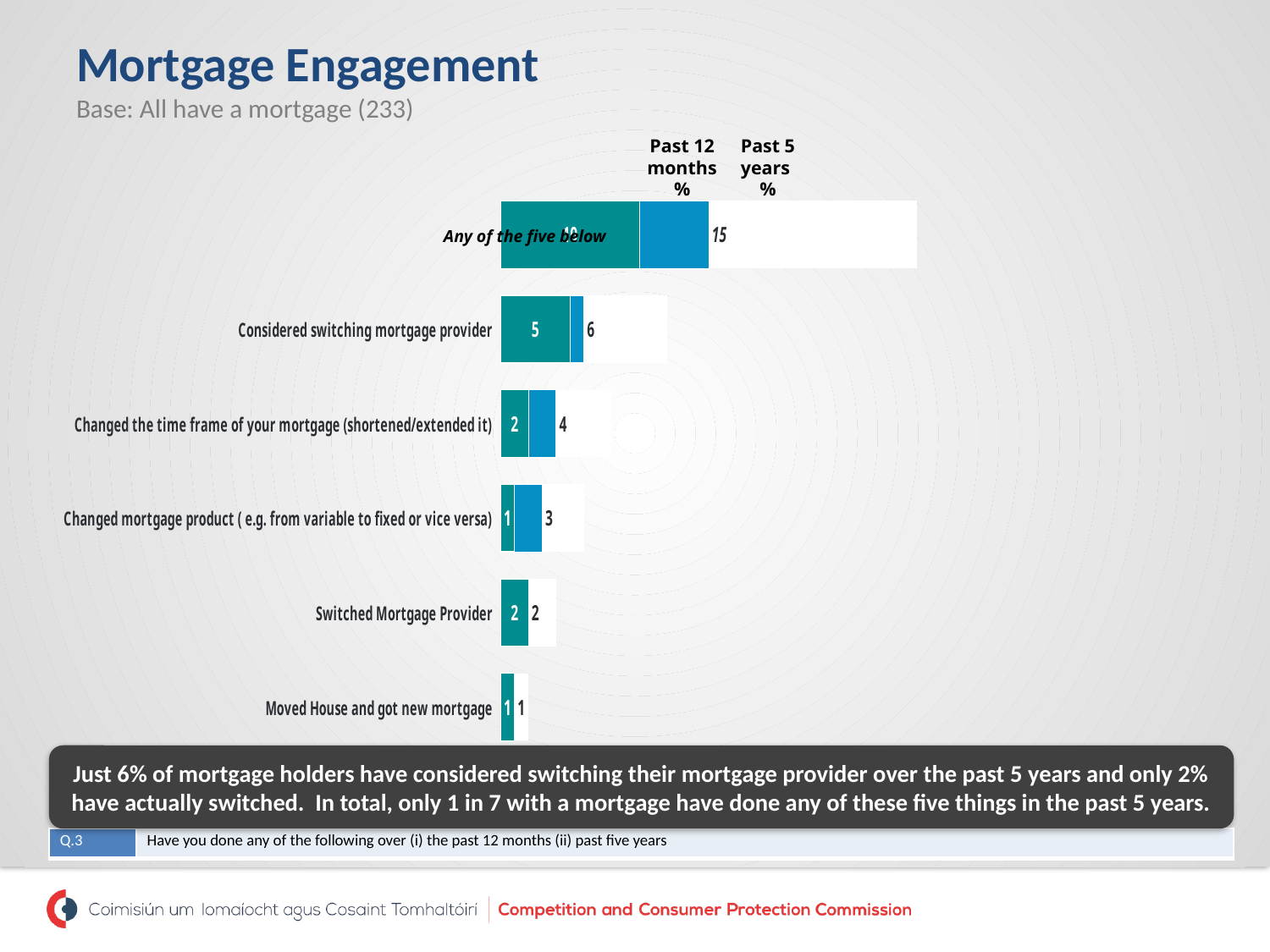
What is the difference between the Past 5 years % and Past 12 months % values for 'Considered switching mortgage provider'? 1 What type of chart is shown on the slide? Bar chart Which is larger for 'Changed the time frame of your mortgage (shortened/extended it)': the Past 12 months % value or the Past 5 years % value? Past 5 years % What is the Past 5 years % value for 'Any of the five below'? 15 What is the Past 5 years % value for 'Changed the time frame of your mortgage (shortened/extended it)'? 4 Which category has the lowest Past 5 years % value? Moved House and got new mortgage What is the Past 12 months % value for 'Switched Mortgage Provider'? 2 What is the Past 5 years % value for 'Changed mortgage product ( e.g. from variable to fixed or vice versa)'? 3 What is the Past 12 months % value for 'Considered switching mortgage provider'? 5 How many categories are shown in the chart? 6 Which category has the highest Past 5 years % value? Any of the five below What is the Past 5 years % value for 'Moved House and got new mortgage'? 1